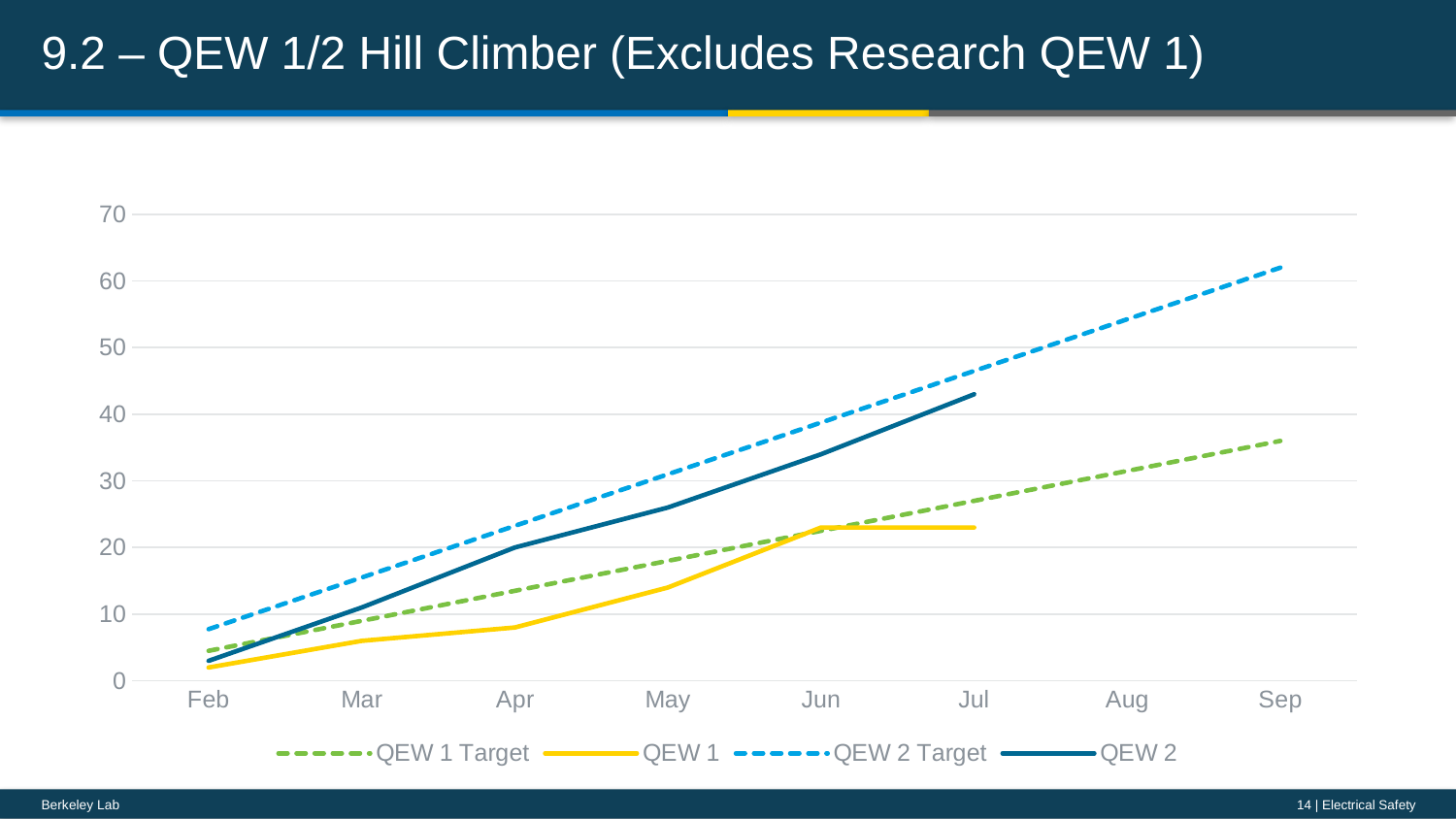
How many series does the legend list? 4 Is the value for QEW 2 in May greater or less than 20? greater What kind of chart is shown on the slide? line chart In Sep, which is larger: QEW 2 Target or QEW 1 Target? QEW 2 Target Is the value for QEW 1 Target in Sep greater or less than 30? greater Is the value for QEW 2 Target in Feb greater or less than 10? less What is the title of the slide containing the chart? 9.2 – QEW 1/2 Hill Climber (Excludes Research QEW 1) How many months are shown on the x axis? 8 Does the QEW 2 Target line rise or fall from Feb to Sep? rise In Jul, which is larger: QEW 2 or QEW 1? QEW 2